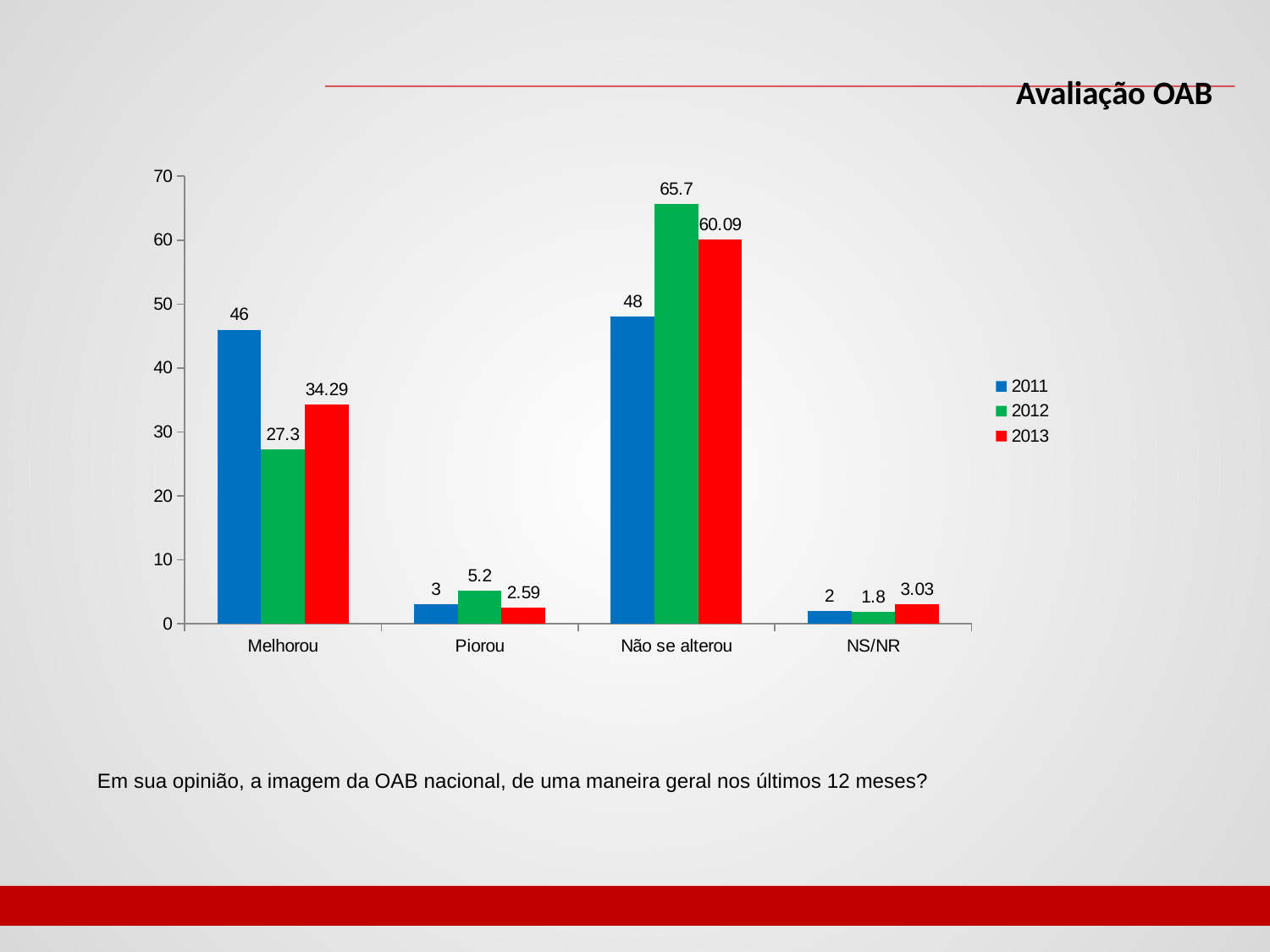
What kind of chart is shown on the slide? bar chart What is the value for 2012 in the Não se alterou category? 65.7 What is the value for 2013 in the Melhorou category? 34.29 How many series does the legend list? 3 Which category has the highest value for the 2011 series? Não se alterou Which colour represents the 2013 series in the legend? red What is the difference between the 2011 and 2012 values in the Melhorou category? 18.7 Which category has the lowest value for the 2012 series? NS/NR What is the value for 2011 in the Piorou category? 3 How many categories are shown on the x axis? 4 Is the 2011 value for Melhorou greater or less than 40? greater Which is larger in the Não se alterou category: the 2012 value or the 2013 value? 2012